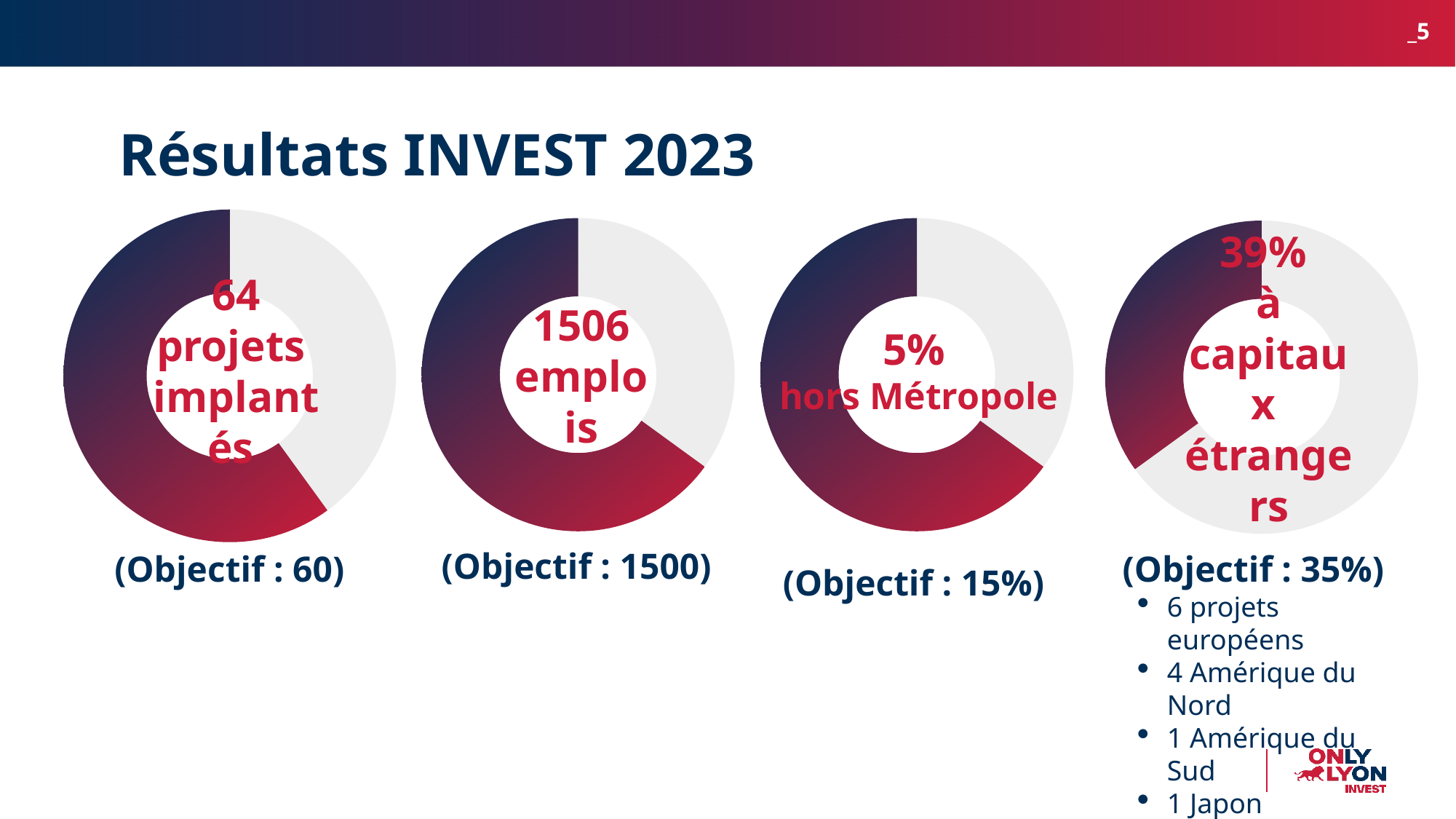
In the third donut chart, what is the stated objectif for hors Métropole? 15% In the first (leftmost) donut chart, what is the stated objectif for projets implantés? 60 In the third donut chart, what percentage is reported as hors Métropole? 5% In the first (leftmost) donut chart, how many projets implantés are reported? 64 How many donut charts are shown on the slide? 4 What is the title of the slide containing the four donut charts? Résultats INVEST 2023 In the fourth (rightmost) donut chart, what percentage is reported as à capitaux étrangers? 39% In the fourth (rightmost) donut chart, by how many percentage points does the reported à capitaux étrangers value exceed its objectif of 35%? 4 In the first (leftmost) donut chart, is the reported number of projets implantés larger or smaller than the objectif? Larger In the second donut chart, what is the stated objectif for emplois? 1500 What kind of chart is used for each of the four visuals on the slide? Donut chart In the second donut chart, how many emplois are reported? 1506